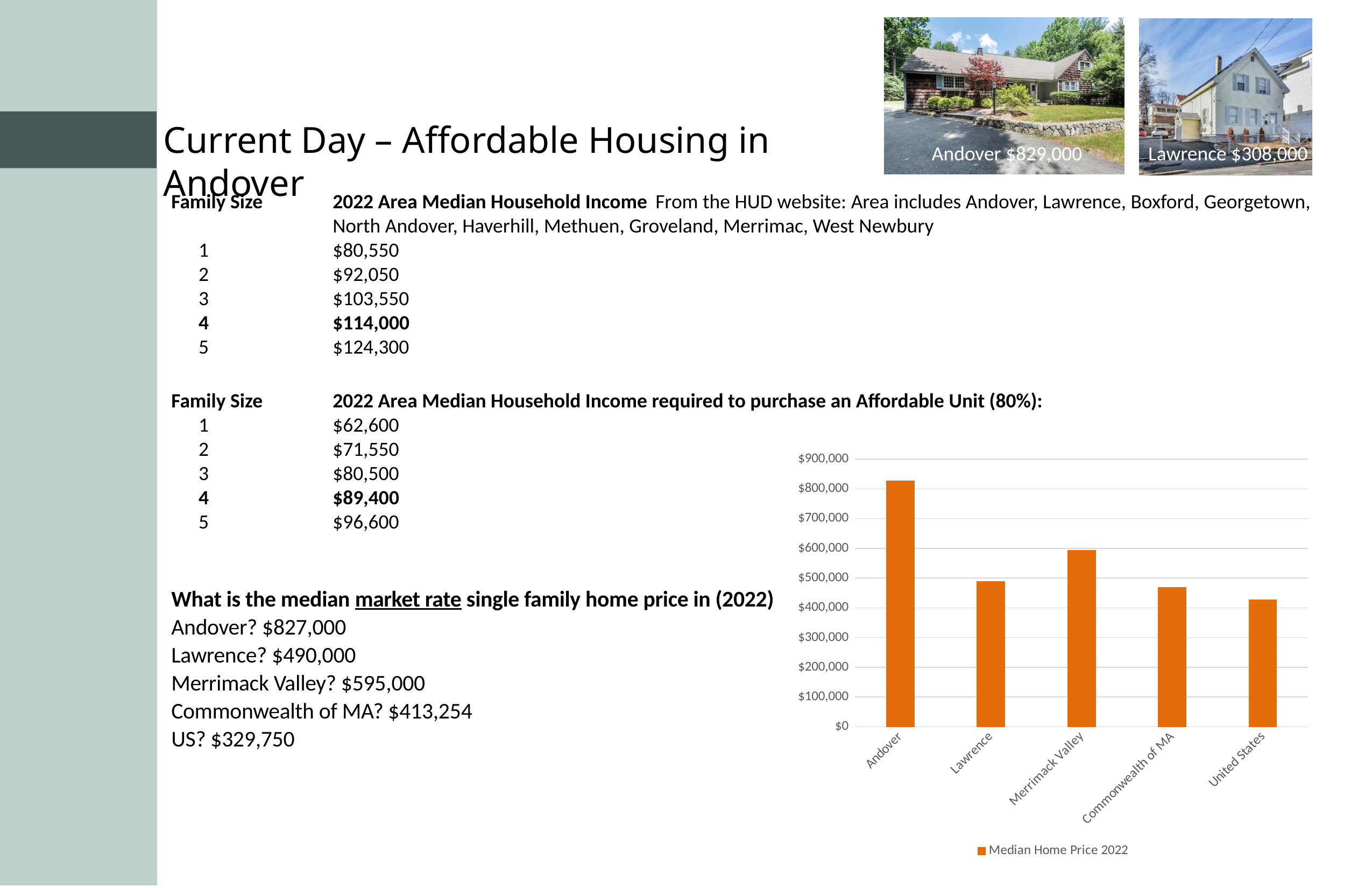
Is the value for Lawrence greater or less than $400,000? greater What kind of chart is shown on the slide? bar chart Is the value for Andover greater or less than $800,000? greater Which has the larger value in the chart, Commonwealth of MA or United States? Commonwealth of MA How many categories are plotted on the x axis of the chart? 5 Which category has the lowest median home price in the chart? United States How many series does the chart legend list? 1 Which has the larger value in the chart, Lawrence or Merrimack Valley? Merrimack Valley What is the series name shown in the chart legend? Median Home Price 2022 Is the value for Merrimack Valley greater or less than $500,000? greater Which category has the highest median home price in the chart? Andover